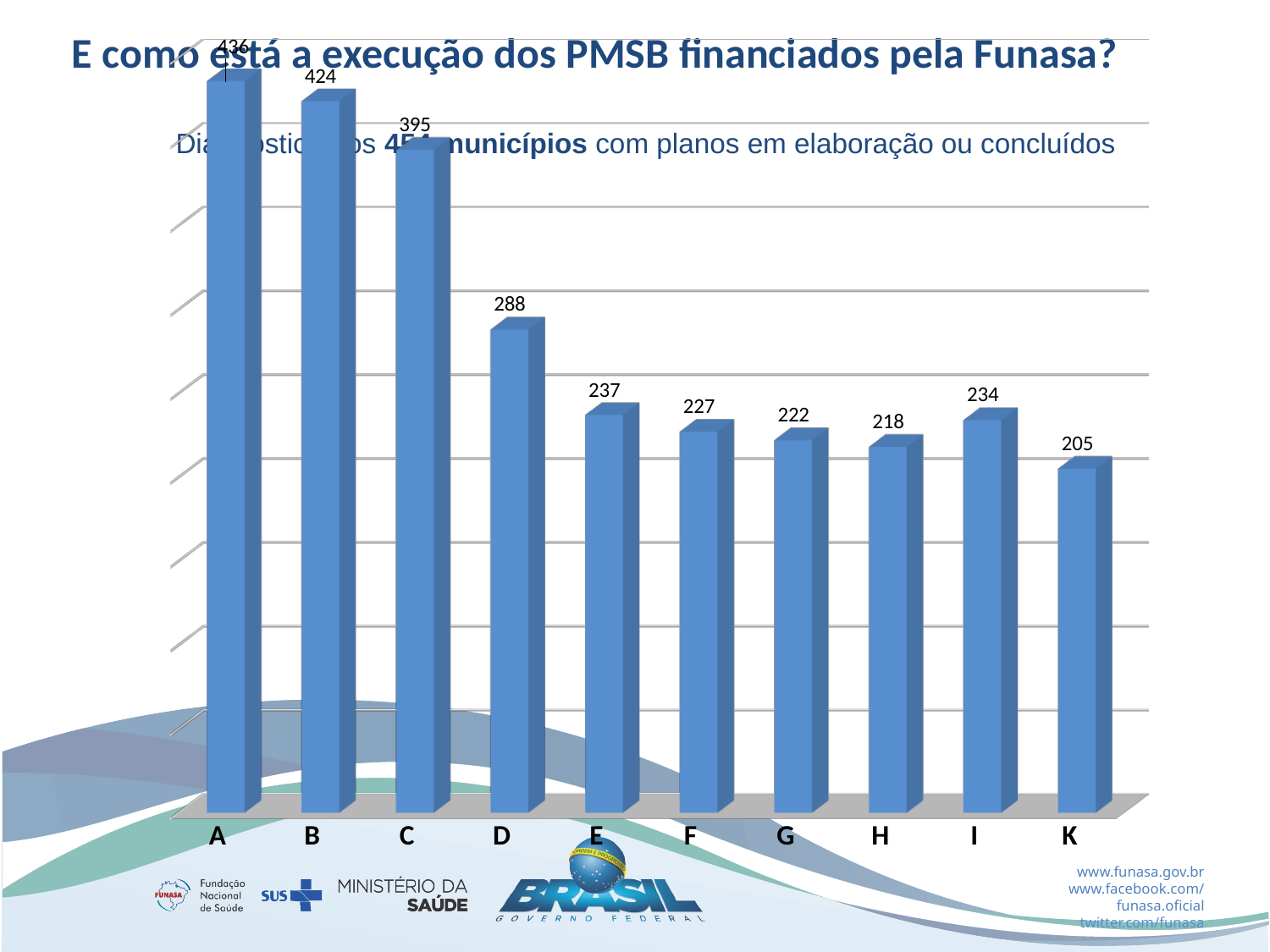
How many categories are shown on the x axis? 10 What is the value for category K? 205 What kind of chart is shown on the slide? Bar chart Which category has the highest value? A What is the value for category D? 288 Do the values generally rise or fall from category A to category D? Fall What is the value for category A? 436 Which is larger, the value for E or the value for I? E What is the difference between the values for A and B? 12 What is the value for category I? 234 What is the difference between the values for C and D? 107 Which category has the lowest value? K